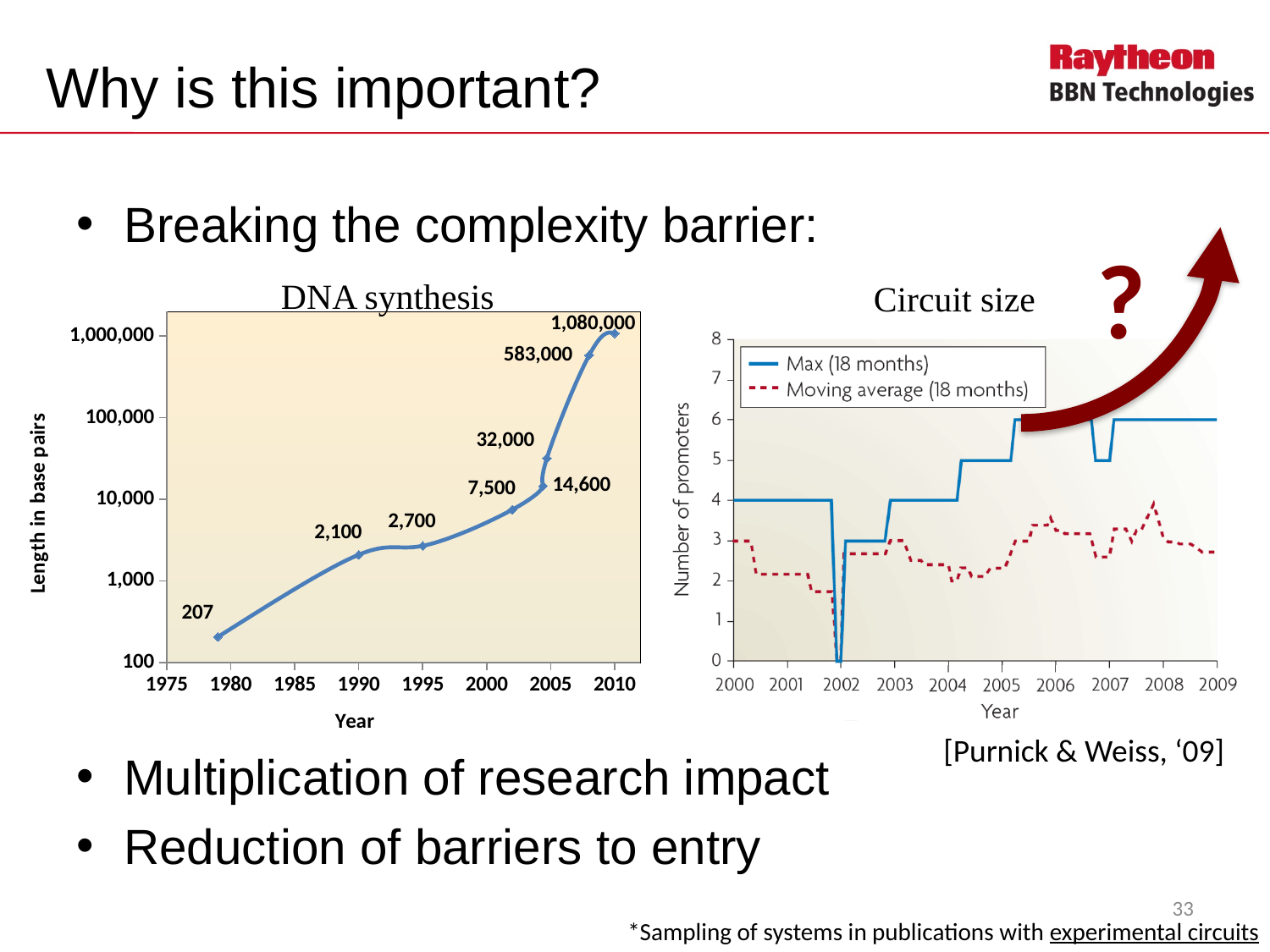
In the DNA synthesis chart, what is the label on the y axis? Length in base pairs In the DNA synthesis chart, what is the difference between the two highest labelled values, 1,080,000 and 583,000? 497,000 In the Circuit size chart, how many series does the legend list? 2 In the DNA synthesis chart, how many data points are labelled with values? 8 What type of chart is the DNA synthesis chart? line chart In the DNA synthesis chart, what is the highest labelled length in base pairs? 1,080,000 In the Circuit size chart, what is the label on the y axis? Number of promoters In the Circuit size chart, is the Moving average (18 months) value in 2001 greater or less than 3? less In the Circuit size chart, is the Max (18 months) value in 2008 greater or less than 5? greater In the DNA synthesis chart, what is the lowest labelled length in base pairs? 207 In the DNA synthesis chart, does the length in base pairs rise or fall as the year increases? rise In the Circuit size chart, which series is higher in 2009, Max (18 months) or Moving average (18 months)? Max (18 months)